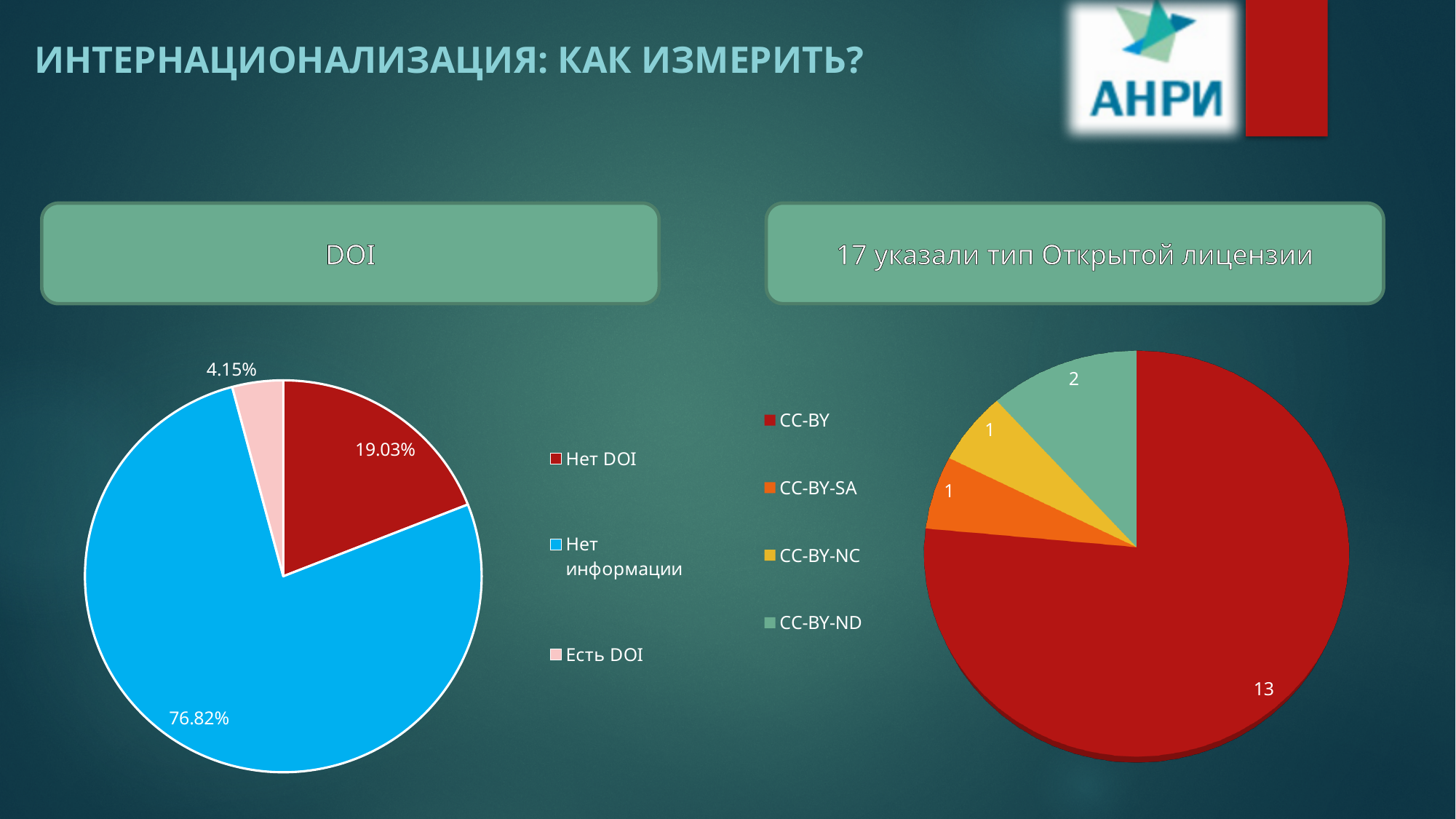
In the DOI pie chart on the left, what percentage is shown for "Нет информации"? 76.82% In the pie chart on the right (17 указали тип Открытой лицензии), what is the total of all slice values? 17 What type of chart is used on the left side of the slide under the heading DOI? Pie chart In the DOI pie chart on the left, what percentage is shown for "Есть DOI"? 4.15% In the pie chart on the right (17 указали тип Открытой лицензии), what value is shown for CC-BY-ND? 2 In the pie chart on the right (17 указали тип Открытой лицензии), how many license types does the legend list? 4 In the DOI pie chart on the left, what is the difference between the shares of "Нет DOI" and "Есть DOI"? 14.88% In the DOI pie chart on the left, what percentage is shown for "Нет DOI"? 19.03% In the pie chart on the right (17 указали тип Открытой лицензии), which license type has the largest slice? CC-BY In the DOI pie chart on the left, which category has the largest share? Нет информации In the pie chart on the right (17 указали тип Открытой лицензии), what value is shown for CC-BY? 13 In the DOI pie chart on the left, which category has the smallest share? Есть DOI